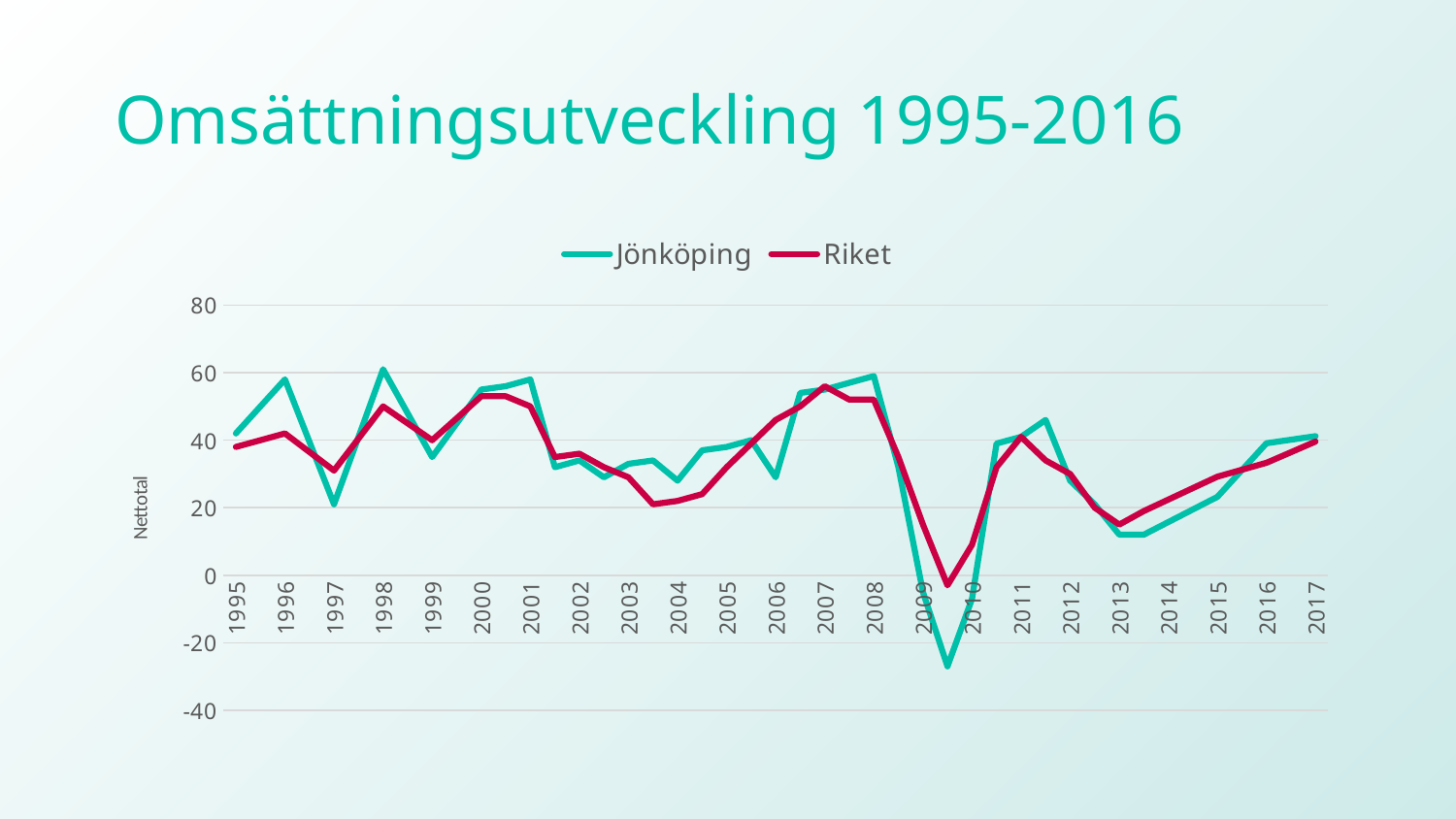
In which year does the Riket series reach its lowest value? 2009 What kind of chart is shown on the slide? line chart How many years are shown on the x axis? 23 How many series does the legend list? 2 In which year does the Jönköping series reach its lowest value? 2009 Is the value for Riket in 2000 greater or less than 40? greater In 2009, which series has the larger value, Jönköping or Riket? Riket Is the value for Jönköping in 2013 greater or less than 20? less Which two series are shown in the legend? Jönköping and Riket In 1996, which series has the larger value, Jönköping or Riket? Jönköping Is the value for Jönköping in 2009 greater or less than -20? less What is the title of the chart on the slide? Omsättningsutveckling 1995-2016